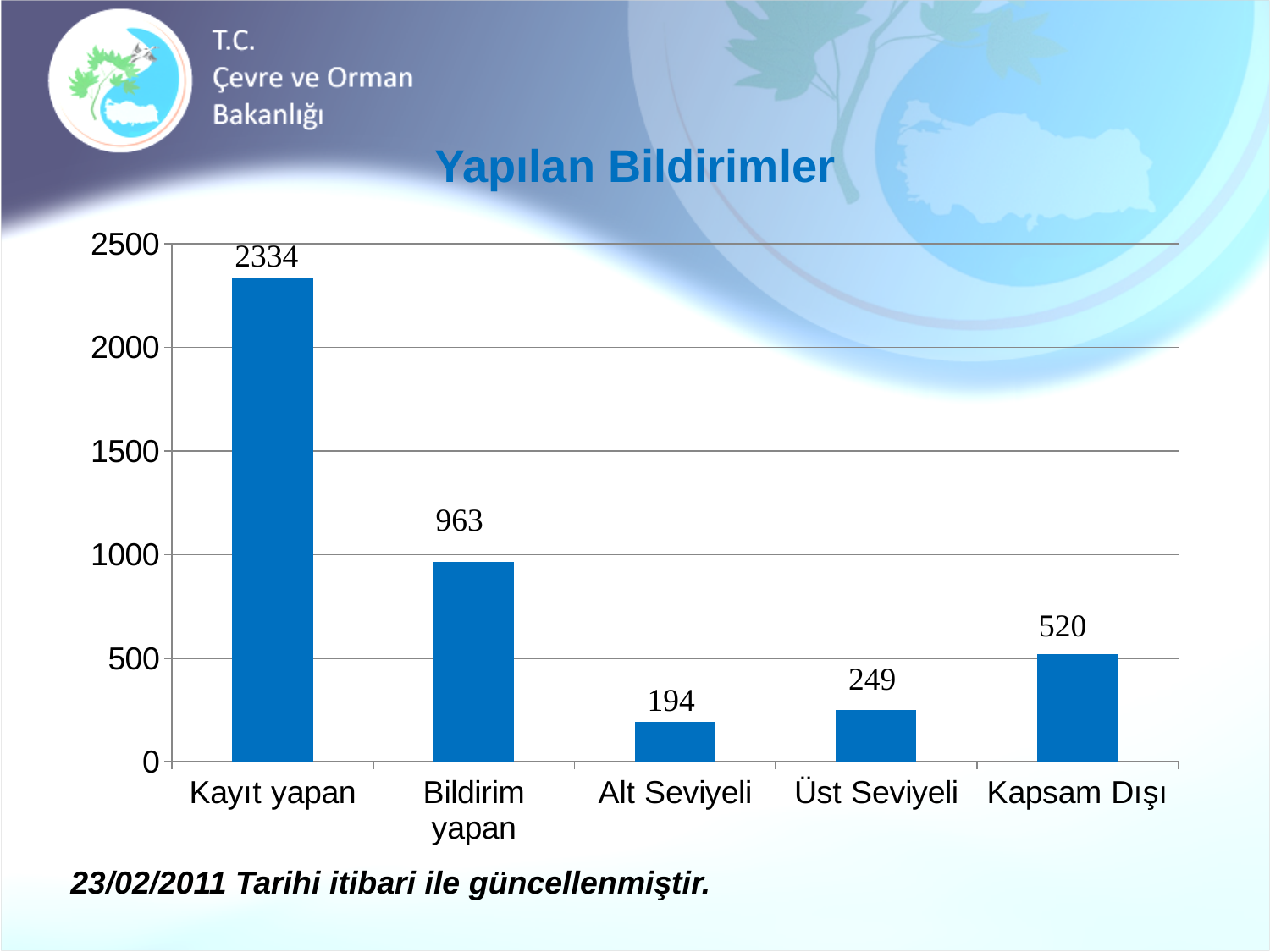
What is the value for Üst Seviyeli? 249 What is the value for Alt Seviyeli? 194 Which category has the lowest value? Alt Seviyeli What is the difference between the values for Kayıt yapan and Bildirim yapan? 1371 Which category has the highest value? Kayıt yapan What is the title of the chart? Yapılan Bildirimler How many categories are shown on the chart? 5 What is the value for Kayıt yapan? 2334 Which is larger, the value for Kapsam Dışı or the value for Üst Seviyeli? Kapsam Dışı What is the value for Bildirim yapan? 963 What is the value for Kapsam Dışı? 520 What kind of chart is shown on the slide? Bar chart